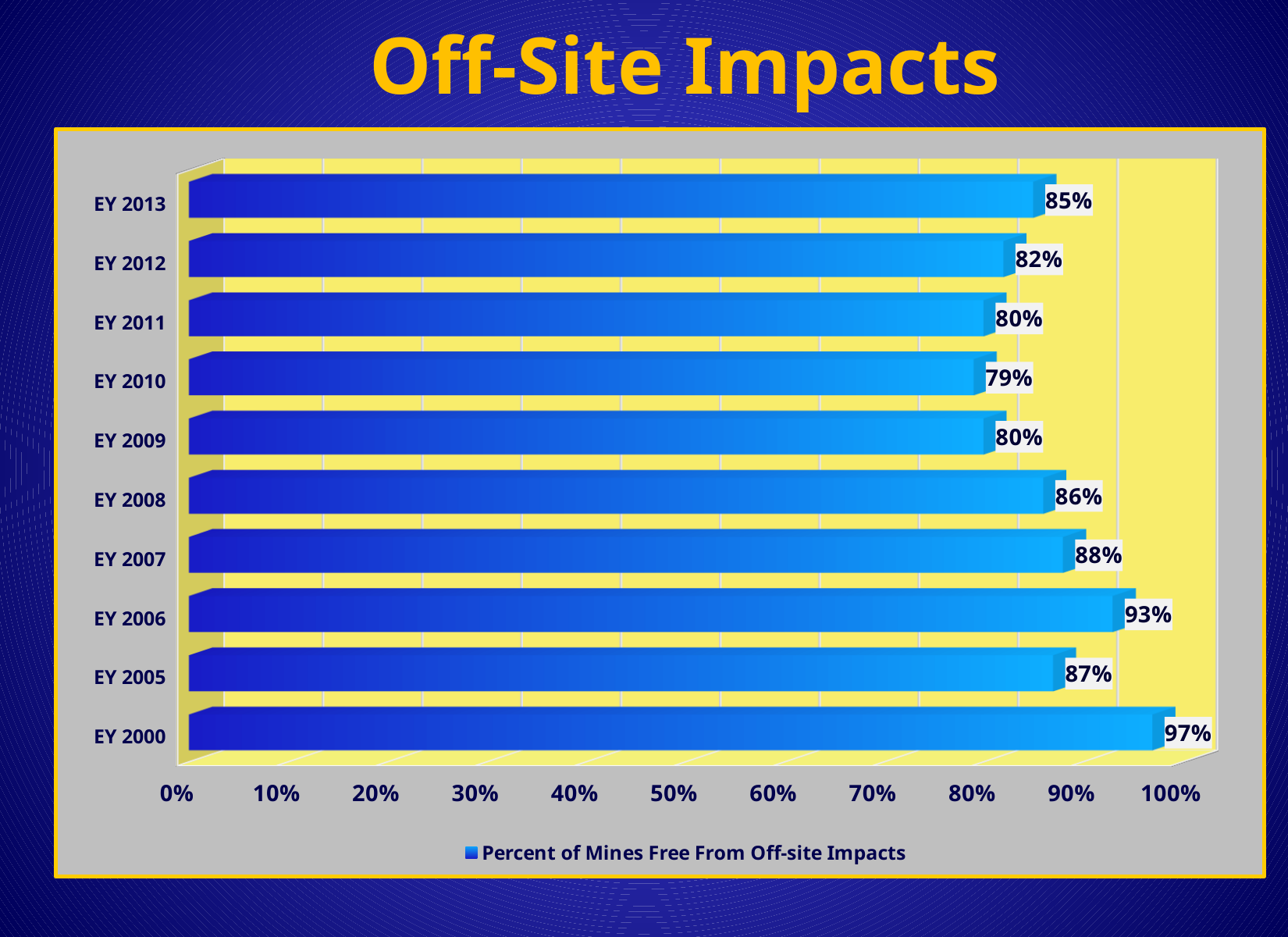
Which year has the highest percent of mines free from off-site impacts? EY 2000 What is the value for EY 2006? 93% Is the value for EY 2005 greater or less than 80%? greater Which year has the lowest percent of mines free from off-site impacts? EY 2010 What is the value for EY 2013? 85% What is the difference between the values for EY 2000 and EY 2013? 12% How many series does the legend list? 1 What is the value for EY 2010? 79% How many years are shown on the chart? 10 Which is larger, the value for EY 2007 or the value for EY 2008? EY 2007 What is the legend entry for the series shown? Percent of Mines Free From Off-site Impacts What kind of chart is shown on the slide? Bar chart